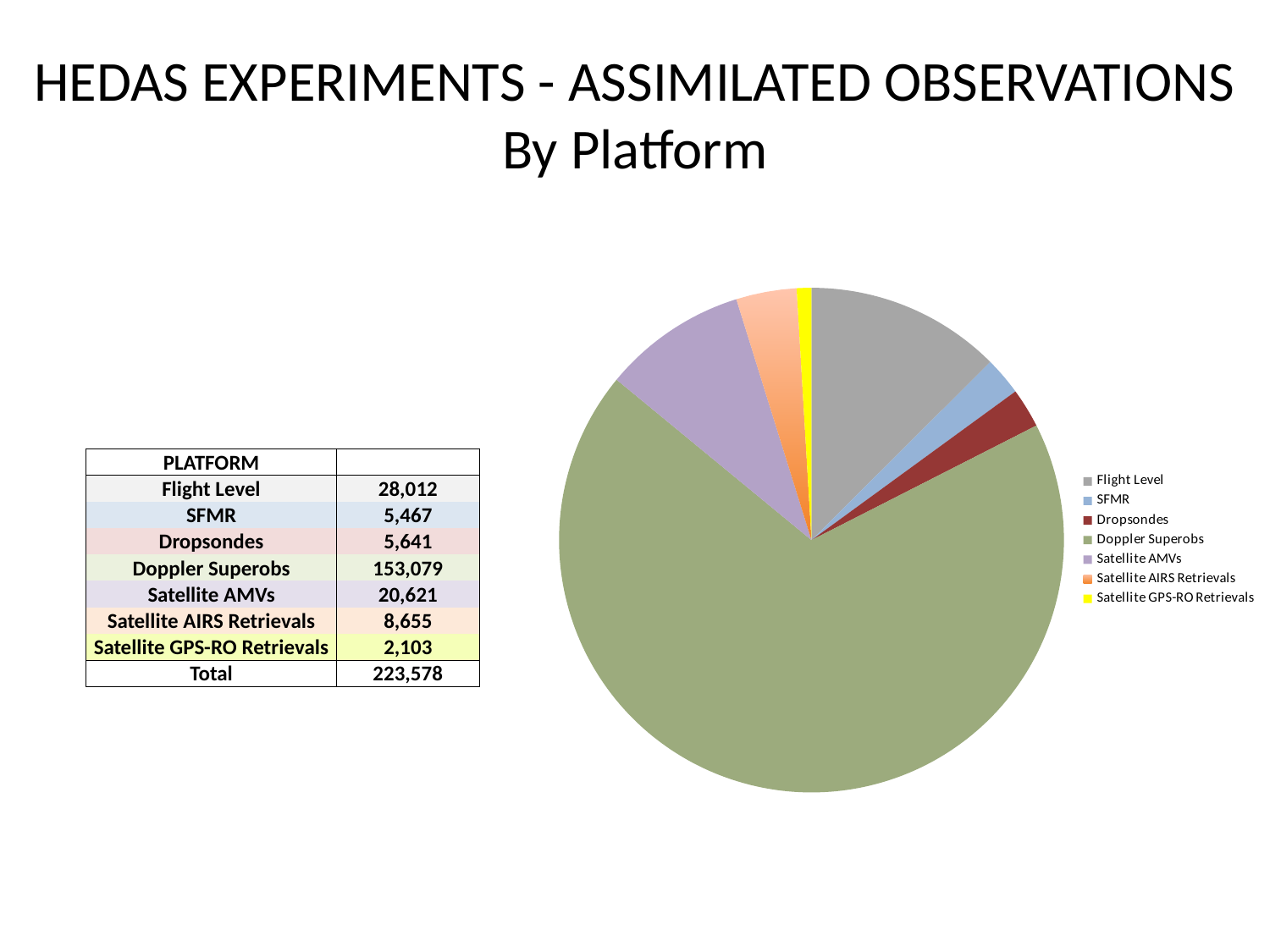
What is the number of assimilated observations for Doppler Superobs? 153,079 What is the difference between the Flight Level and Satellite AMVs observation counts? 7,391 Which has more assimilated observations, Flight Level or Satellite AIRS Retrievals? Flight Level How many entries does the legend of the pie chart list? 7 What is the number of assimilated observations for Satellite GPS-RO Retrievals? 2,103 What is the number of assimilated observations for Satellite AMVs? 20,621 What is the total number of assimilated observations across all platforms? 223,578 What colour is the Doppler Superobs slice in the pie chart? green Which platform has the largest slice of the pie chart? Doppler Superobs How many platforms (slices) does the pie chart show? 7 Which platform has the smallest slice of the pie chart? Satellite GPS-RO Retrievals What kind of chart is shown on the slide? pie chart